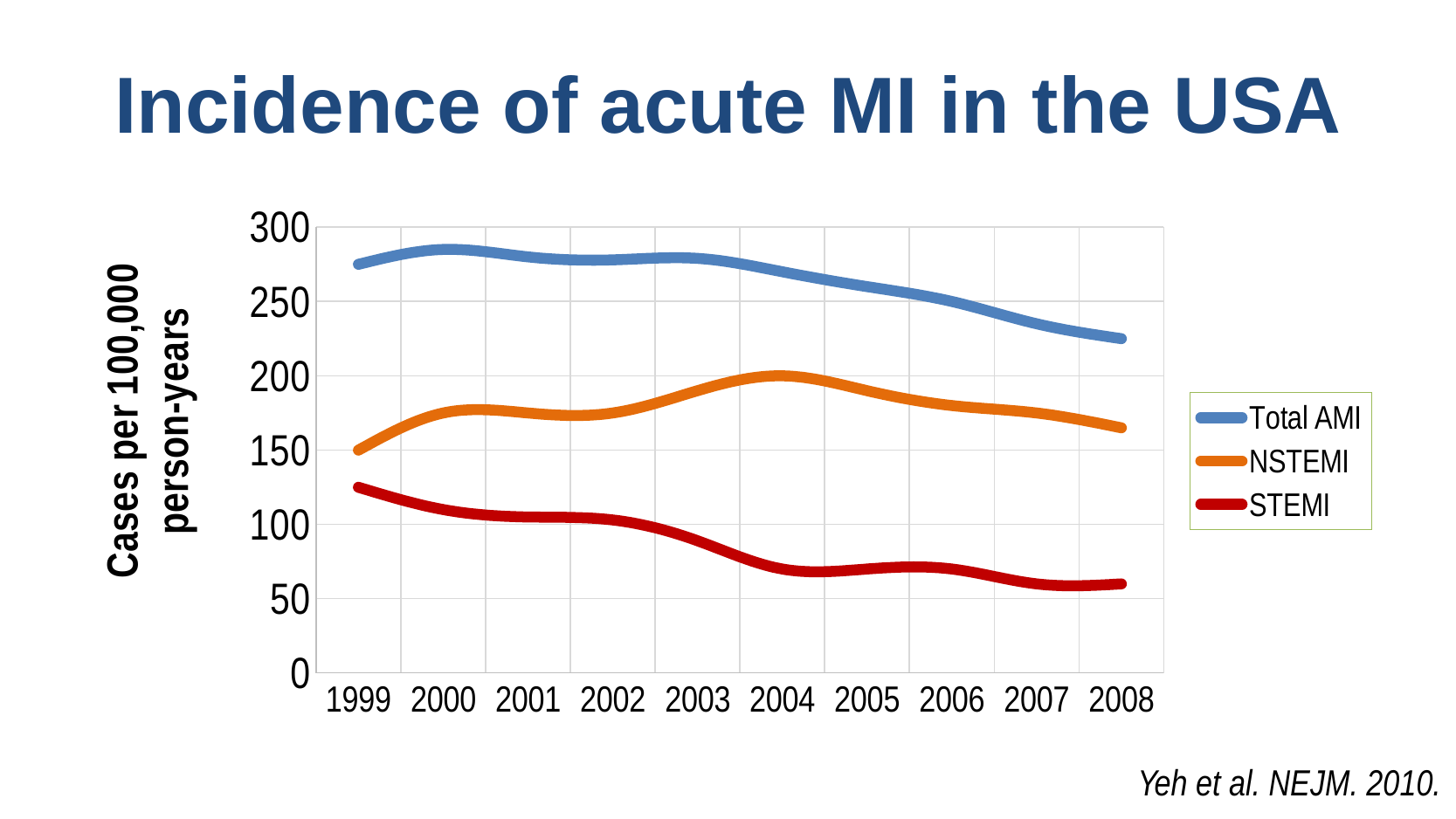
What kind of chart is shown on the slide? line chart Which series has the lowest values throughout the chart? STEMI Does the STEMI series rise or fall from 1999 to 2008? fall Is the value for STEMI in 2004 greater or less than 100? less How many series does the legend list? 3 In which year is the Total AMI series at its lowest? 2008 Which series has the highest values throughout the chart? Total AMI Is the value for Total AMI in 2008 greater or less than 250? less How many years are plotted along the x axis? 10 What is the label of the y axis? Cases per 100,000 person-years Is the value for Total AMI in 1999 greater or less than 250? greater In which year does the NSTEMI series reach its highest value? 2004